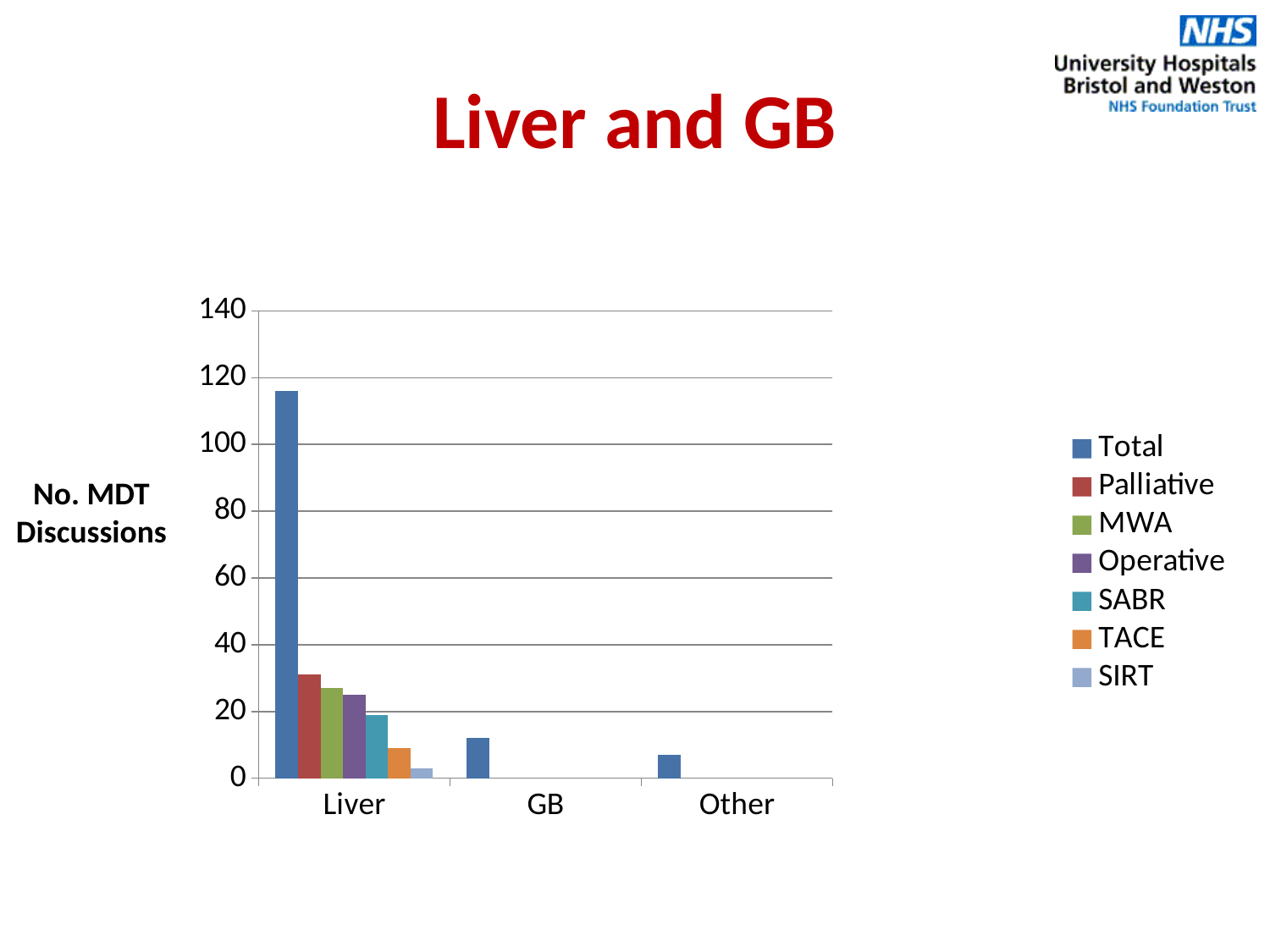
Which is larger for Liver, the Palliative value or the SIRT value? Palliative Is the Palliative value for Liver greater or less than 40? less Is the Total value for GB greater or less than 20? less Is the Total value for Liver greater or less than 100? greater What kind of chart is shown on the slide? bar chart What is the label on the vertical axis of the chart? No. MDT Discussions How many categories are shown on the x axis? 3 How many series does the legend list? 7 What is the title of the slide containing the chart? Liver and GB Which series has the lowest value for Liver? SIRT Which category has the highest Total value? Liver Which category has the lowest Total value? Other